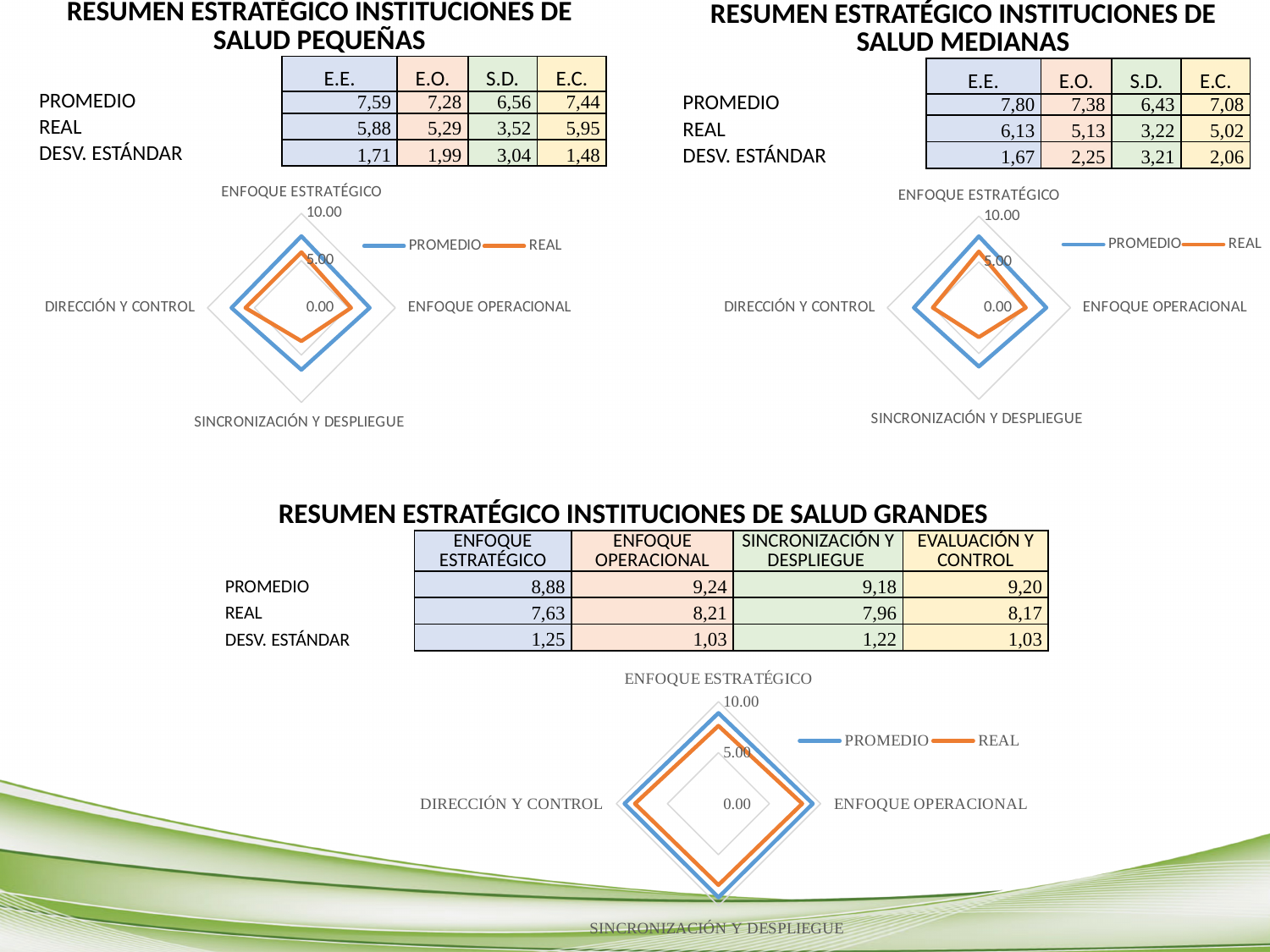
What kind of chart is shown under the title RESUMEN ESTRATÉGICO INSTITUCIONES DE SALUD PEQUEÑAS? Radar chart In the RESUMEN ESTRATÉGICO INSTITUCIONES DE SALUD PEQUEÑAS chart, is the REAL value for SINCRONIZACIÓN Y DESPLIEGUE greater or less than 5.00? less According to the RESUMEN ESTRATÉGICO INSTITUCIONES DE SALUD PEQUEÑAS table, what is the PROMEDIO value for E.E.? 7,59 In the RESUMEN ESTRATÉGICO INSTITUCIONES DE SALUD MEDIANAS chart, which series is larger for ENFOQUE ESTRATÉGICO, PROMEDIO or REAL? PROMEDIO How many axes (categories) does the RESUMEN ESTRATÉGICO INSTITUCIONES DE SALUD MEDIANAS radar chart have? 4 In the RESUMEN ESTRATÉGICO INSTITUCIONES DE SALUD GRANDES chart, is the REAL value for DIRECCIÓN Y CONTROL greater or less than 5.00? greater In the RESUMEN ESTRATÉGICO INSTITUCIONES DE SALUD PEQUEÑAS chart, on which axis is the REAL series lowest? SINCRONIZACIÓN Y DESPLIEGUE In the RESUMEN ESTRATÉGICO INSTITUCIONES DE SALUD GRANDES chart, how many series does the legend list? 2 According to the RESUMEN ESTRATÉGICO INSTITUCIONES DE SALUD MEDIANAS table, what is the REAL value for S.D.? 3,22 In the RESUMEN ESTRATÉGICO INSTITUCIONES DE SALUD PEQUEÑAS chart, what colour is the REAL series line? Orange According to the RESUMEN ESTRATÉGICO INSTITUCIONES DE SALUD GRANDES table, what is the PROMEDIO value for ENFOQUE OPERACIONAL? 9,24 In the RESUMEN ESTRATÉGICO INSTITUCIONES DE SALUD GRANDES data, what is the difference between PROMEDIO and REAL for ENFOQUE ESTRATÉGICO? 1,25